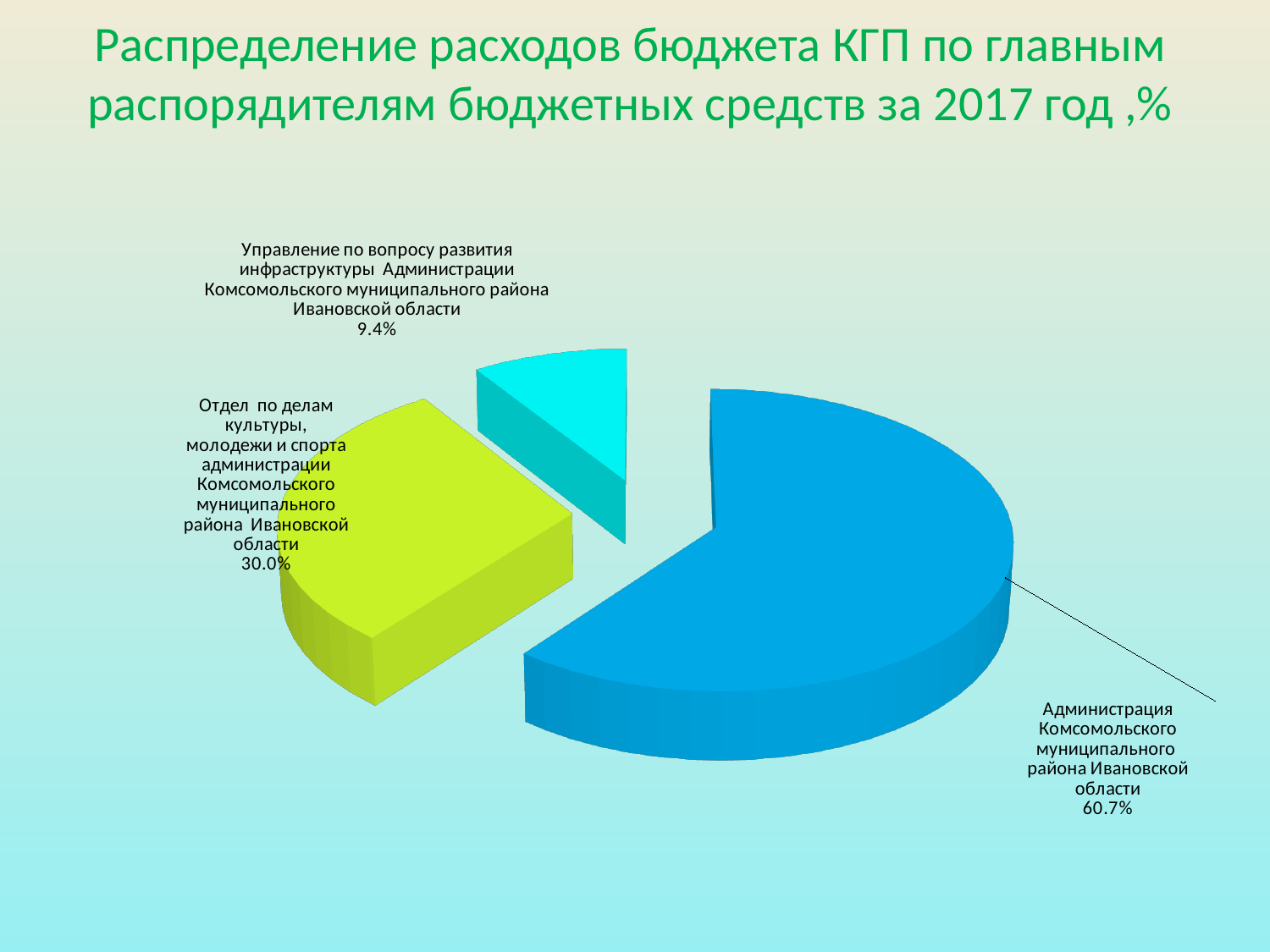
Which main budget administrator has the largest share of expenditures? Администрация Комсомольского муниципального района Ивановской области What is the title of the chart on the slide? Распределение расходов бюджета КГП по главным распорядителям бюджетных средств за 2017 год ,% How many slices does the pie chart have? 3 What type of chart is shown on the slide? Pie chart What colour is the slice for Отдел по делам культуры, молодежи и спорта? Yellow-green What share of the budget expenditures goes to Отдел по делам культуры, молодежи и спорта? 30.0% What share of the budget expenditures goes to Администрация Комсомольского муниципального района Ивановской области? 60.7% Which has a larger share: Отдел по делам культуры, молодежи и спорта or Управление по вопросу развития инфраструктуры? Отдел по делам культуры, молодежи и спорта What is the difference in percentage points between the share of Администрация Комсомольского муниципального района and the share of Отдел по делам культуры, молодежи и спорта? 30.7 Which main budget administrator has the smallest share of expenditures? Управление по вопросу развития инфраструктуры Администрации Комсомольского муниципального района Ивановской области What is the difference in percentage points between the share of Отдел по делам культуры, молодежи и спорта and the share of Управление по вопросу развития инфраструктуры? 20.6 What share of the budget expenditures goes to Управление по вопросу развития инфраструктуры? 9.4%